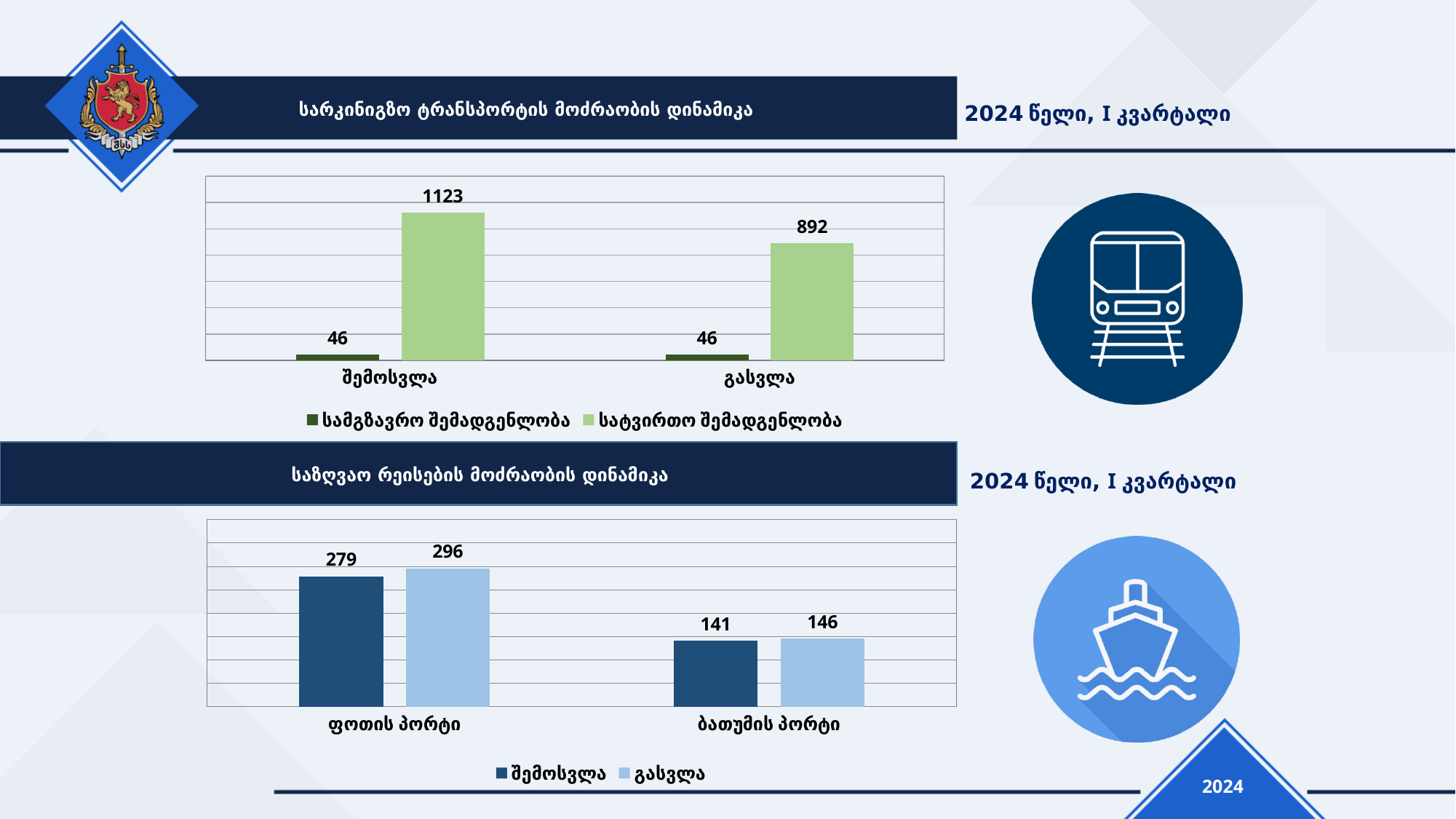
In the top chart, what is the value of სატვირთო შემადგენლობა for გასვლა? 892 In the bottom chart, which port has the higher შემოსვლა value? ფოთის პორტი In the bottom chart, what is the difference between the გასვლა values for ფოთის პორტი and ბათუმის პორტი? 150 In the bottom chart (საზღვაო რეისების მოძრაობის დინამიკა), what is the შემოსვლა value for ფოთის პორტი? 279 In the top chart, how many series does the legend list? 2 What kind of chart is the top chart? Bar chart In the bottom chart, what is the გასვლა value for ბათუმის პორტი? 146 What period is stated next to the title of the bottom chart? 2024 წელი, I კვარტალი In the bottom chart, how many categories are shown on the x axis? 2 In the top chart (სარკინიგზო ტრანსპორტის მოძრაობის დინამიკა), what is the value of სატვირთო შემადგენლობა for შემოსვლა? 1123 In the top chart, what is the difference between the სატვირთო შემადგენლობა values for შემოსვლა and გასვლა? 231 In the top chart, what is the value of სამგზავრო შემადგენლობა for შემოსვლა? 46